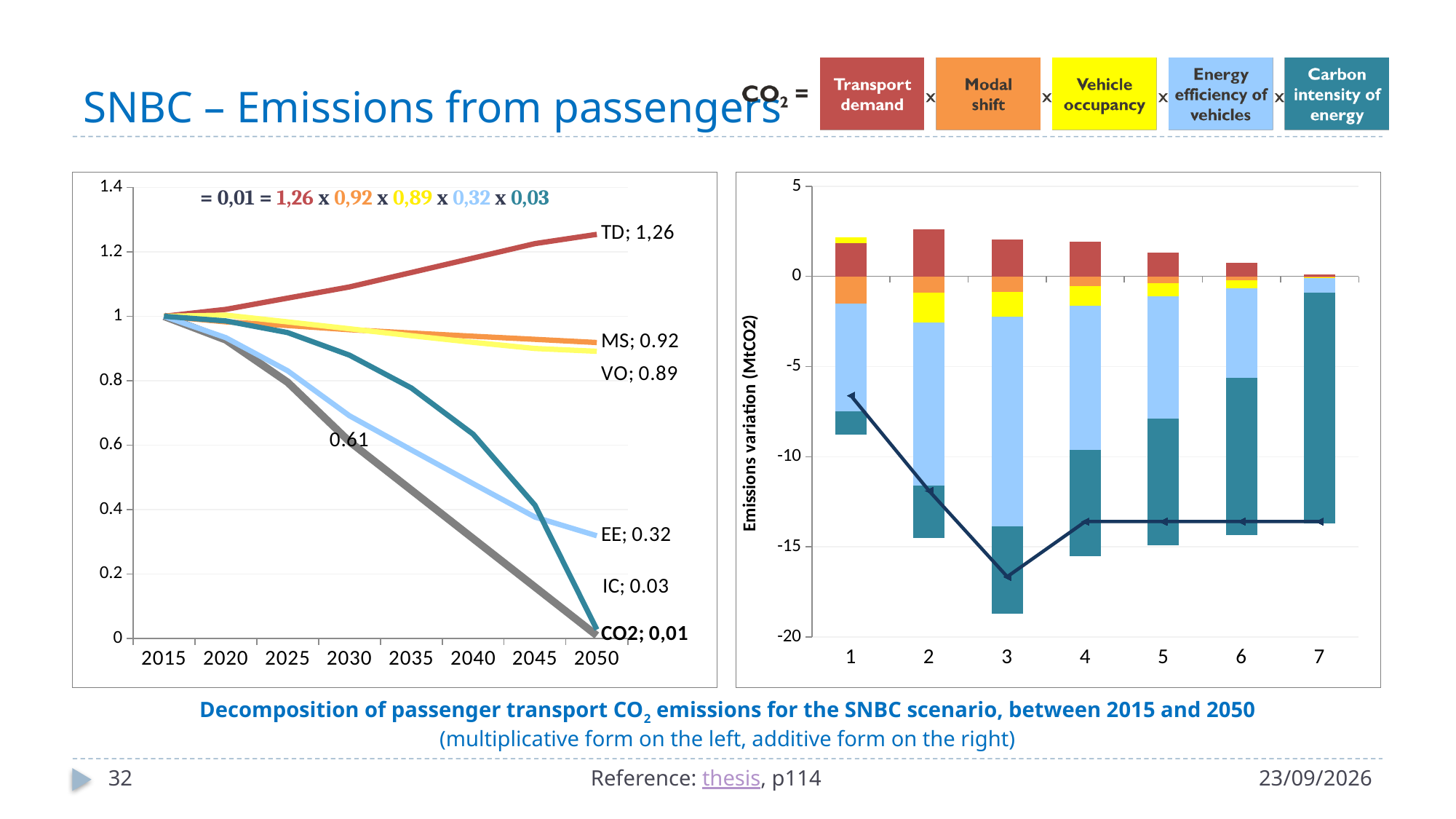
What kind of chart is the right chart? combination stacked bar and line chart In the left chart, does the TD line rise or fall from 2015 to 2050? rise In the left chart, which series has the highest value in 2050? TD In the left chart, what is the value of MS in 2050? 0.92 In the left chart, which series has the lowest value in 2050? CO2 In the left chart, what is the value of CO2 in 2050? 0,01 In the right chart, is the value of the line at category 3 greater or less than -15? less In the left chart, which is larger in 2050, EE or IC? EE In the left chart, what is the value of IC in 2050? 0.03 In the left chart, what is the value of EE in 2050? 0.32 In the right chart, how many categories are shown on the x axis? 7 In the left chart, what is the value of TD in 2050? 1,26